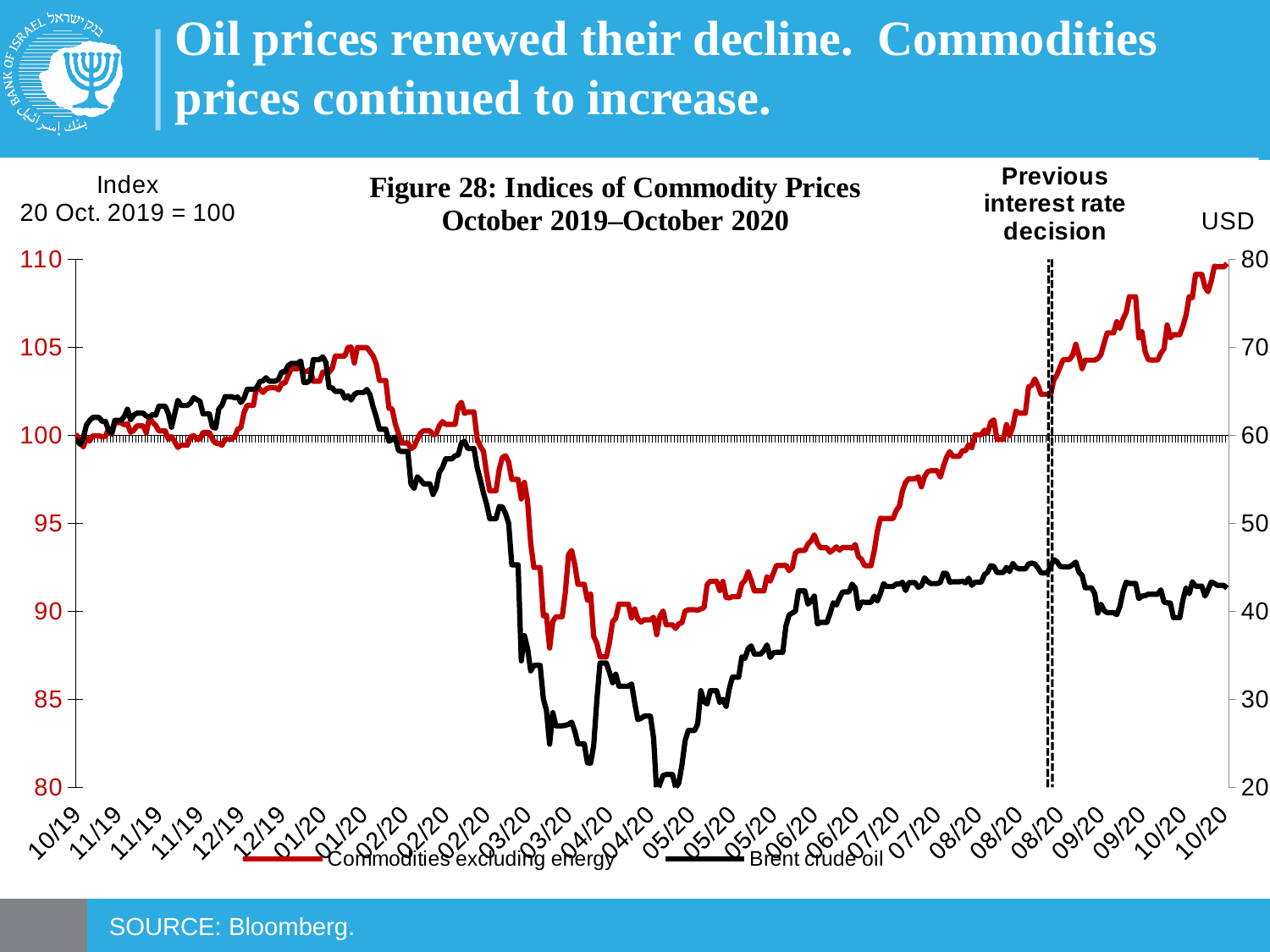
Is the value of Commodities excluding energy at the end of October 2020 greater or less than 105? greater What is the base date of the index in Figure 28 (index = 100)? 20 Oct. 2019 Is the value of Brent crude oil at the end of October 2020 greater or less than 50 USD? less What kind of chart is Figure 28? line chart What does the dashed vertical line in Figure 28 mark? Previous interest rate decision Is the lowest value of Brent crude oil, reached around April 2020, greater or less than 30 USD? less Does the Commodities excluding energy line rise or fall between May 2020 and October 2020? rise Does the Brent crude oil line rise or fall between January 2020 and April 2020? fall Does the Brent crude oil line rise or fall between September 2020 and October 2020? fall How many series does the legend of Figure 28 list? 2